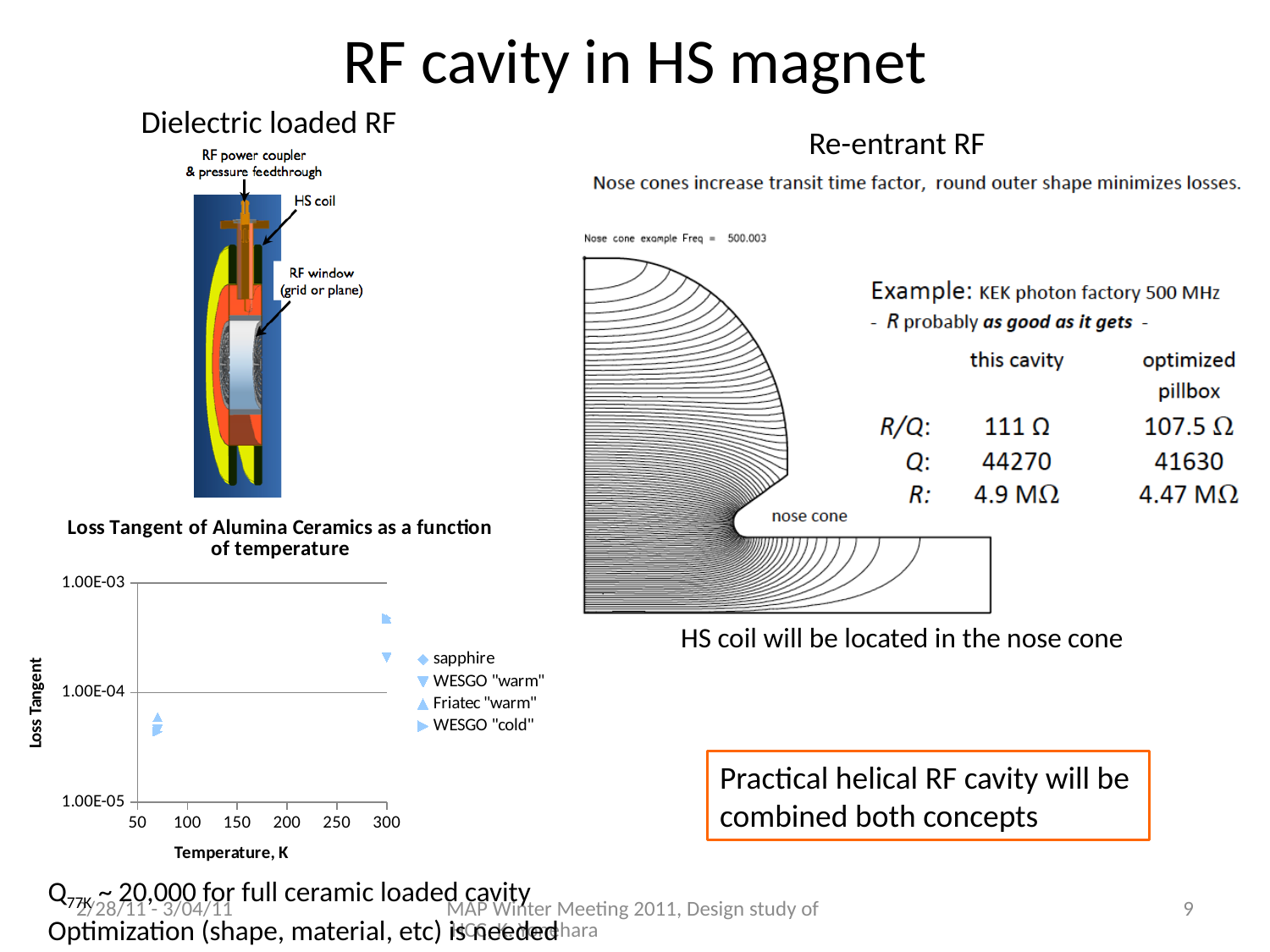
In the Loss Tangent chart, which series has the higher value near 300 K, WESGO "cold" or WESGO "warm"? WESGO "cold" What is the title of the chart on the slide? Loss Tangent of Alumina Ceramics as a function of temperature In the Loss Tangent chart, does the loss tangent rise or fall as temperature increases from 50 K to 300 K? rise In the Loss Tangent chart, are the values plotted near 70 K greater or less than 1.00E-04? less What kind of chart is the Loss Tangent chart? scatter chart In the Loss Tangent chart, is the WESGO "cold" value near 300 K greater or less than 1.00E-03? less In the Loss Tangent chart, is the WESGO "warm" value near 300 K greater or less than 1.00E-04? greater What is the label of the x axis of the Loss Tangent chart? Temperature, K In the Loss Tangent chart, which series has the highest plotted loss tangent? WESGO "cold" What is the lowest tick value shown on the y axis of the Loss Tangent chart? 1.00E-05 How many series does the legend of the Loss Tangent chart list? 4